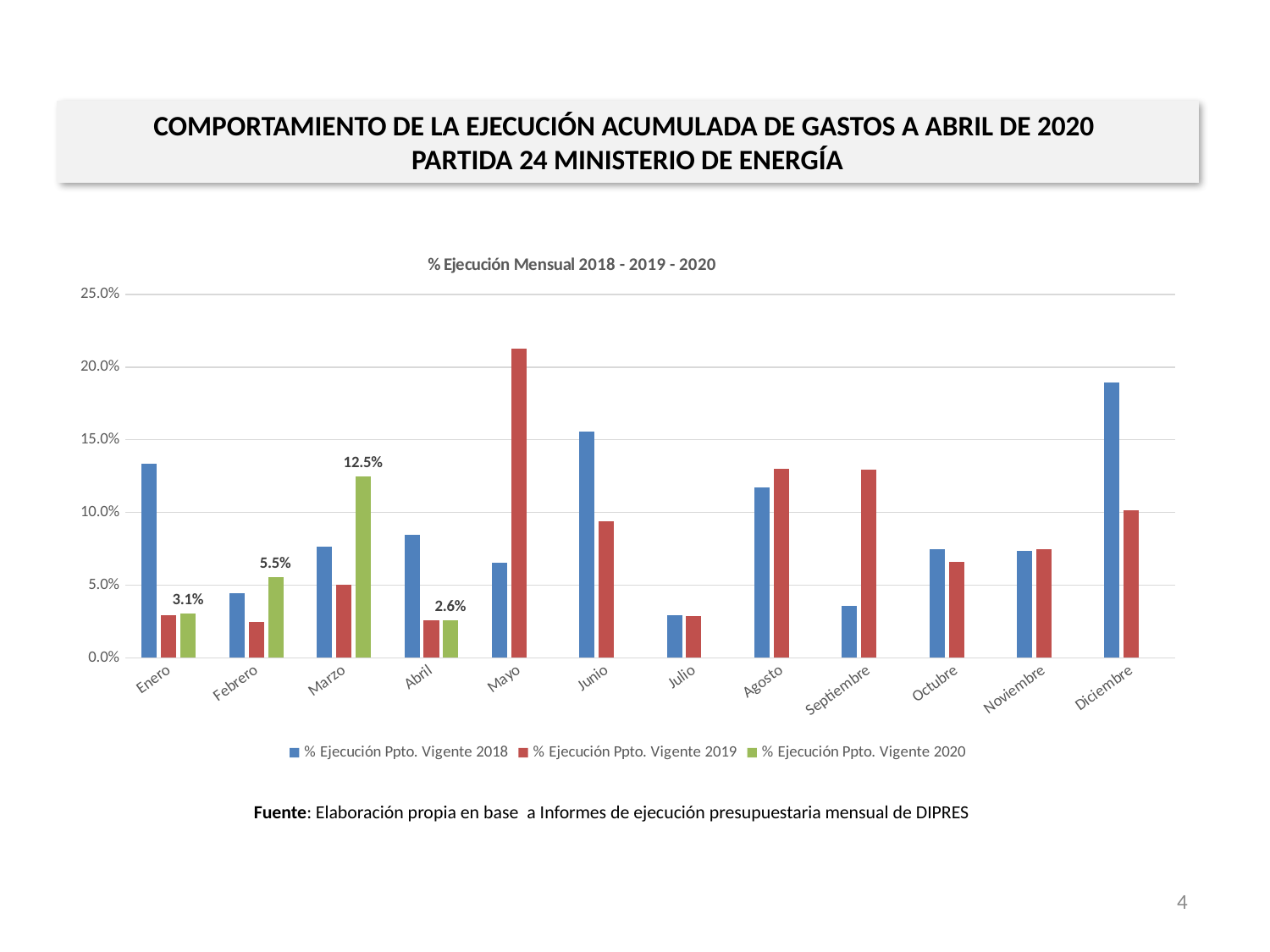
What is the value of % Ejecución Ppto. Vigente 2020 for Marzo? 12.5% Which is larger for % Ejecución Ppto. Vigente 2020: Enero or Abril? Enero Which month has the lowest value for % Ejecución Ppto. Vigente 2020? Abril How many series does the legend list? 3 How many months are shown on the x axis of the chart? 12 Which month has the highest value for % Ejecución Ppto. Vigente 2020? Marzo Is the value for % Ejecución Ppto. Vigente 2019 in Mayo greater or less than 20.0%? greater What kind of chart is shown on the slide? Bar chart What is the value of % Ejecución Ppto. Vigente 2020 for Enero? 3.1% What is the difference between the 2020 values for Marzo and Febrero? 7.0% Is the value for % Ejecución Ppto. Vigente 2018 in Diciembre greater or less than 15.0%? greater Which month has the highest value for % Ejecución Ppto. Vigente 2019? Mayo